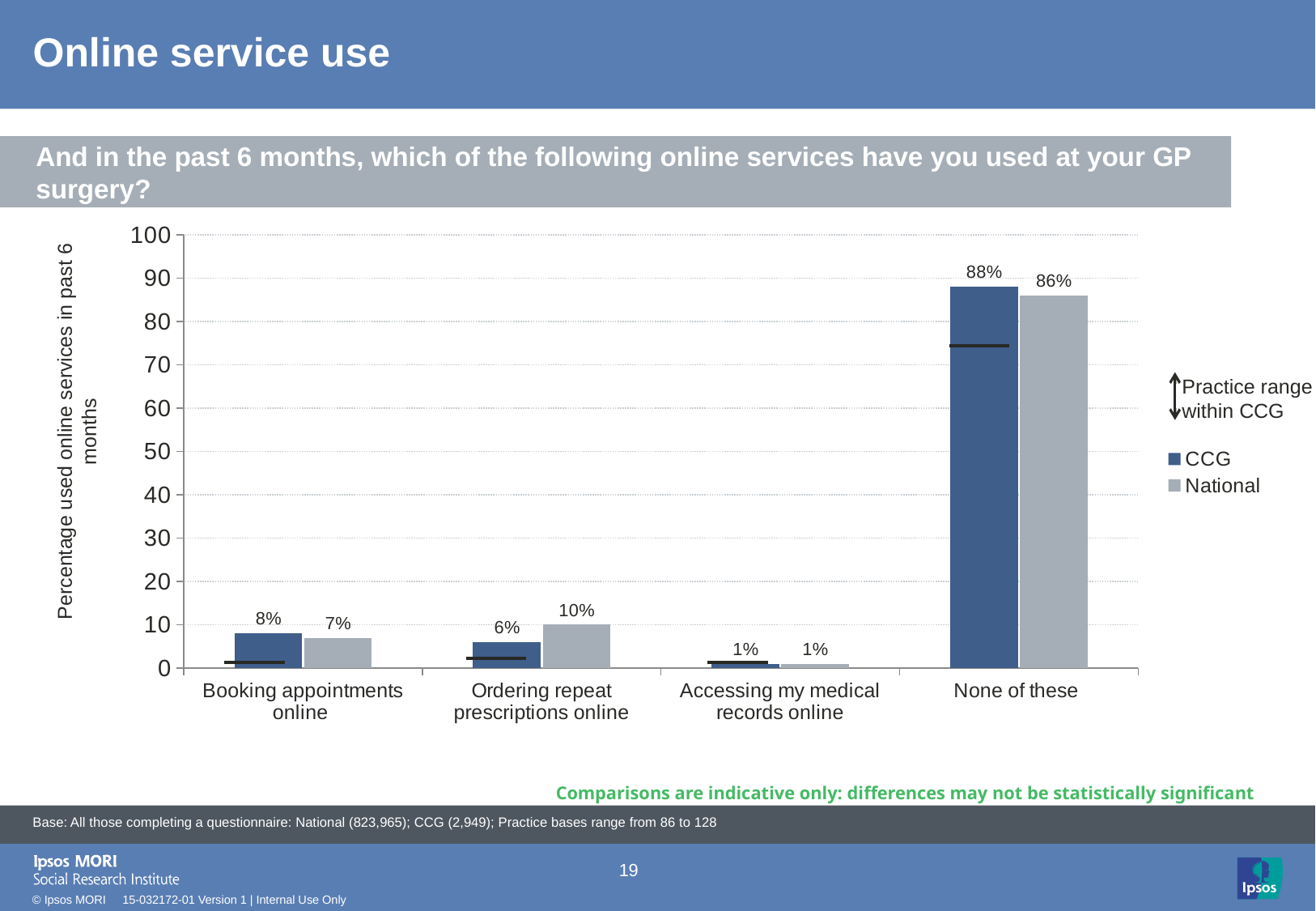
What is the National value for Accessing my medical records online? 1% What is the CCG value for Booking appointments online? 8% Which category has the highest CCG value? None of these Which category has the lowest National value? Accessing my medical records online What is the difference between the CCG and National values for None of these? 2% How many data series does the legend list? 2 How many categories are shown on the x axis? 4 Which is larger for Ordering repeat prescriptions online, the CCG value or the National value? National Is the CCG value for None of these greater or less than 80? greater What kind of chart is shown on the slide? Bar chart What is the CCG value for None of these? 88% What is the National value for Ordering repeat prescriptions online? 10%